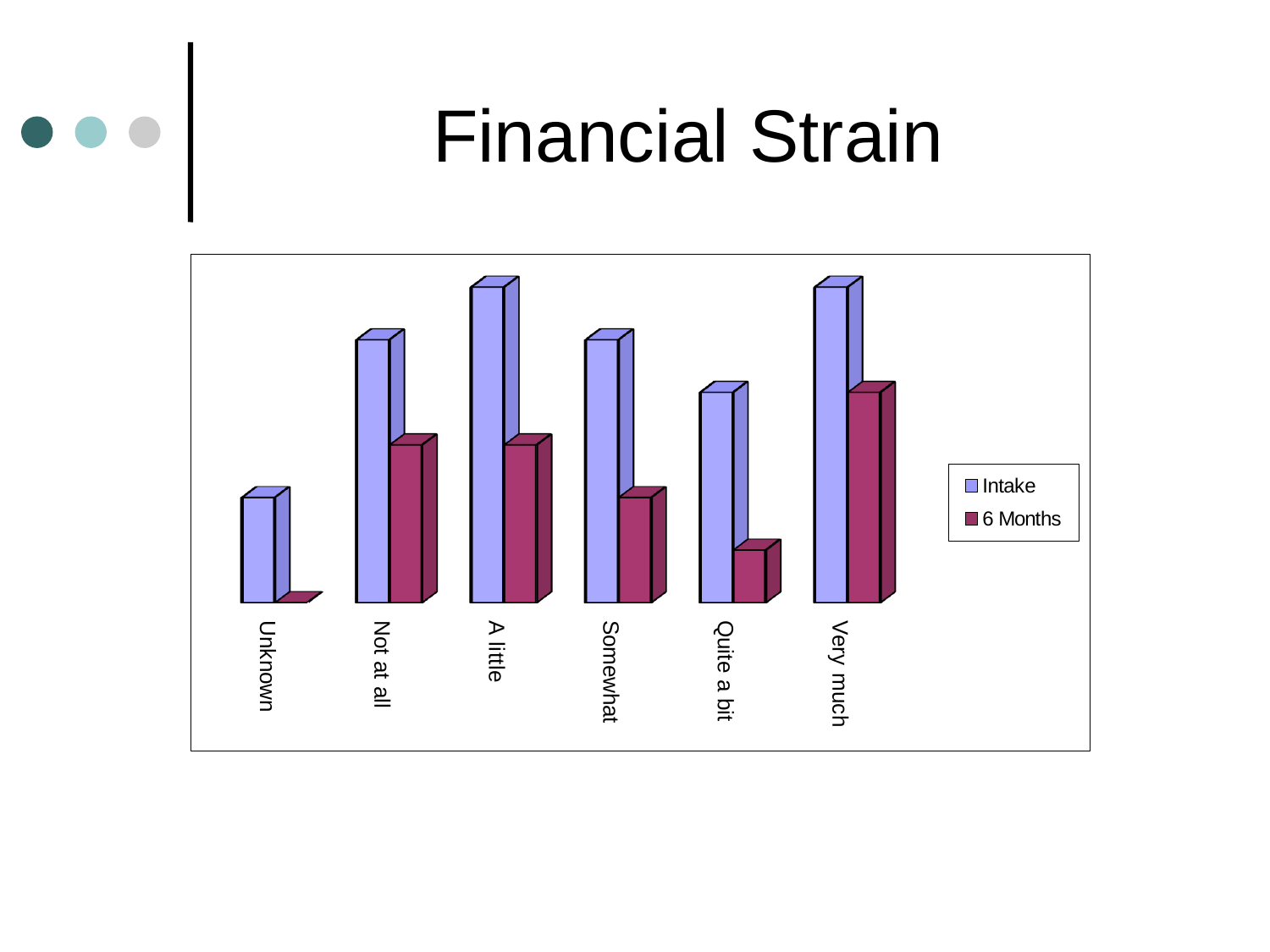
Which category has the highest 6 Months value? Very much How many series does the chart's legend list? 2 What kind of chart is shown on the slide? Bar chart Which category has the lowest Intake value? Unknown What are the two series named in the legend? Intake and 6 Months Which is larger: the Intake value for Somewhat or the Intake value for Quite a bit? Somewhat For the category Very much, which is larger: the Intake value or the 6 Months value? Intake How many categories are shown along the x axis of the chart? 6 Which category has the lowest 6 Months value? Unknown What is the title of the slide containing the chart? Financial Strain Which is larger: the 6 Months value for Very much or the 6 Months value for Not at all? Very much